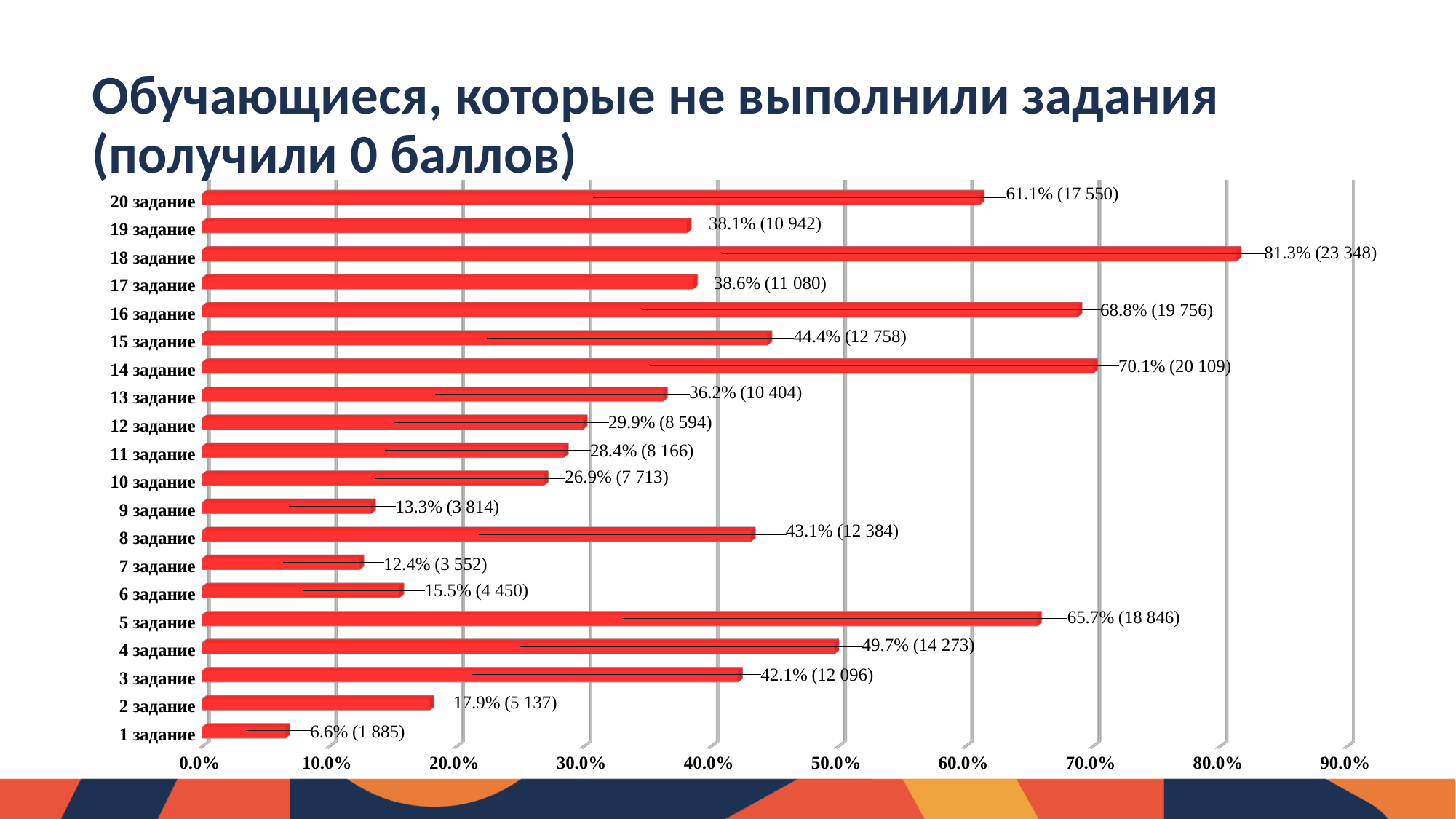
What type of chart is shown on the slide? Bar chart What percentage is shown for 18 задание? 81.3% What is the data label for 5 задание? 65.7% (18 846) Which task has the highest percentage of students who scored 0 points? 18 задание How many students are shown in parentheses for 14 задание? 20 109 What percentage is shown for 1 задание? 6.6% Which task has the lowest percentage of students who scored 0 points? 1 задание What is the difference in percentage points between 18 задание and 14 задание? 11.2 How many tasks (categories) are shown on the chart? 20 What colour are the bars in the chart? Red Is the value for 15 задание greater or less than 40.0%? greater Which has a higher percentage, 5 задание or 16 задание? 16 задание